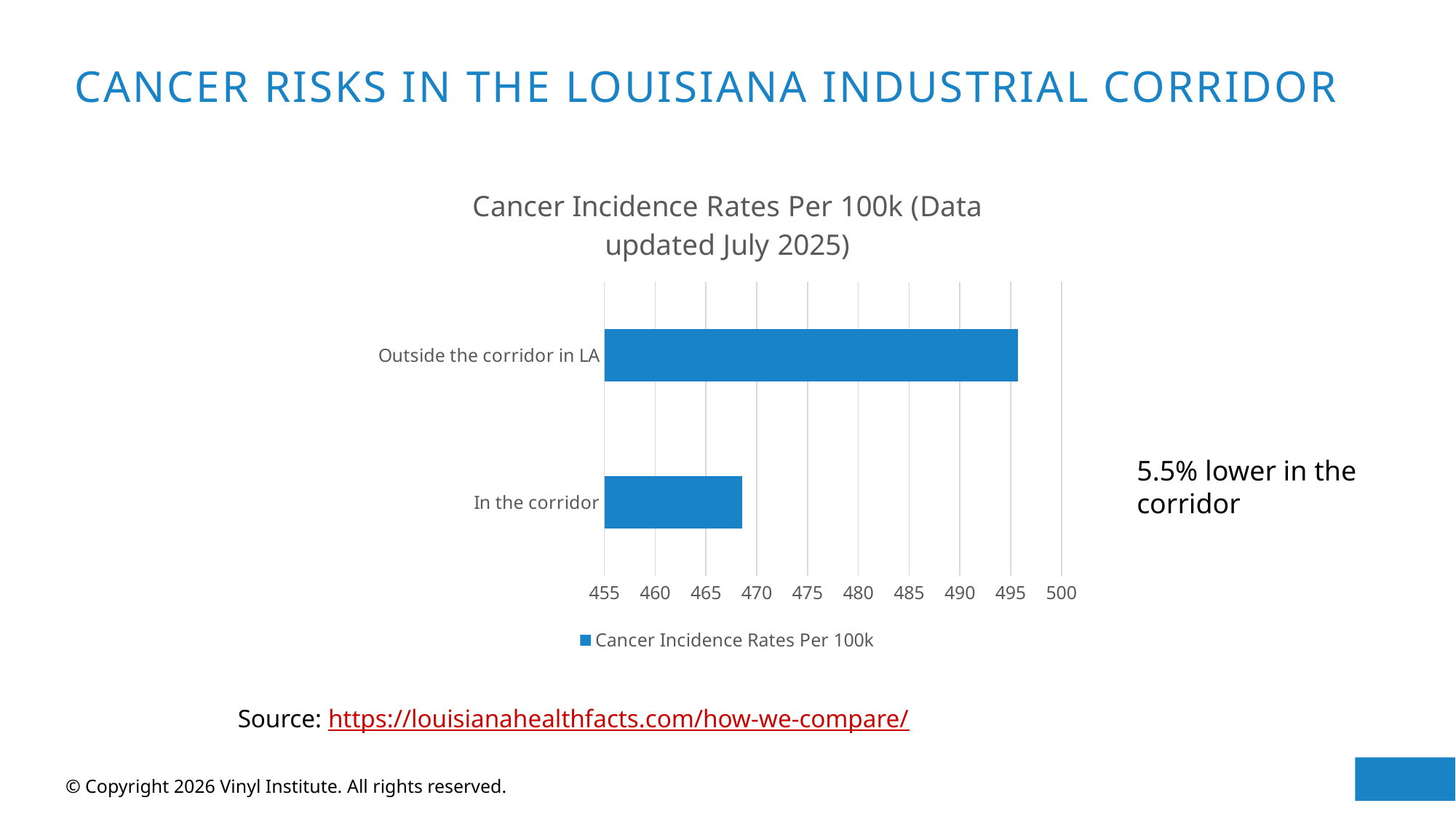
Is the value for Outside the corridor in LA greater or less than 490? greater How many series does the legend list? 1 What is the title of the chart? Cancer Incidence Rates Per 100k (Data updated July 2025) Is the value for Outside the corridor in LA greater or less than 500? less Is the value for In the corridor greater or less than 465? greater What series name is shown in the chart legend? Cancer Incidence Rates Per 100k Which category has the lowest cancer incidence rate? In the corridor How many categories are plotted in the chart? 2 Which is larger, the value for Outside the corridor in LA or the value for In the corridor? Outside the corridor in LA Which category has the highest cancer incidence rate? Outside the corridor in LA What kind of chart is shown on the slide? Bar chart